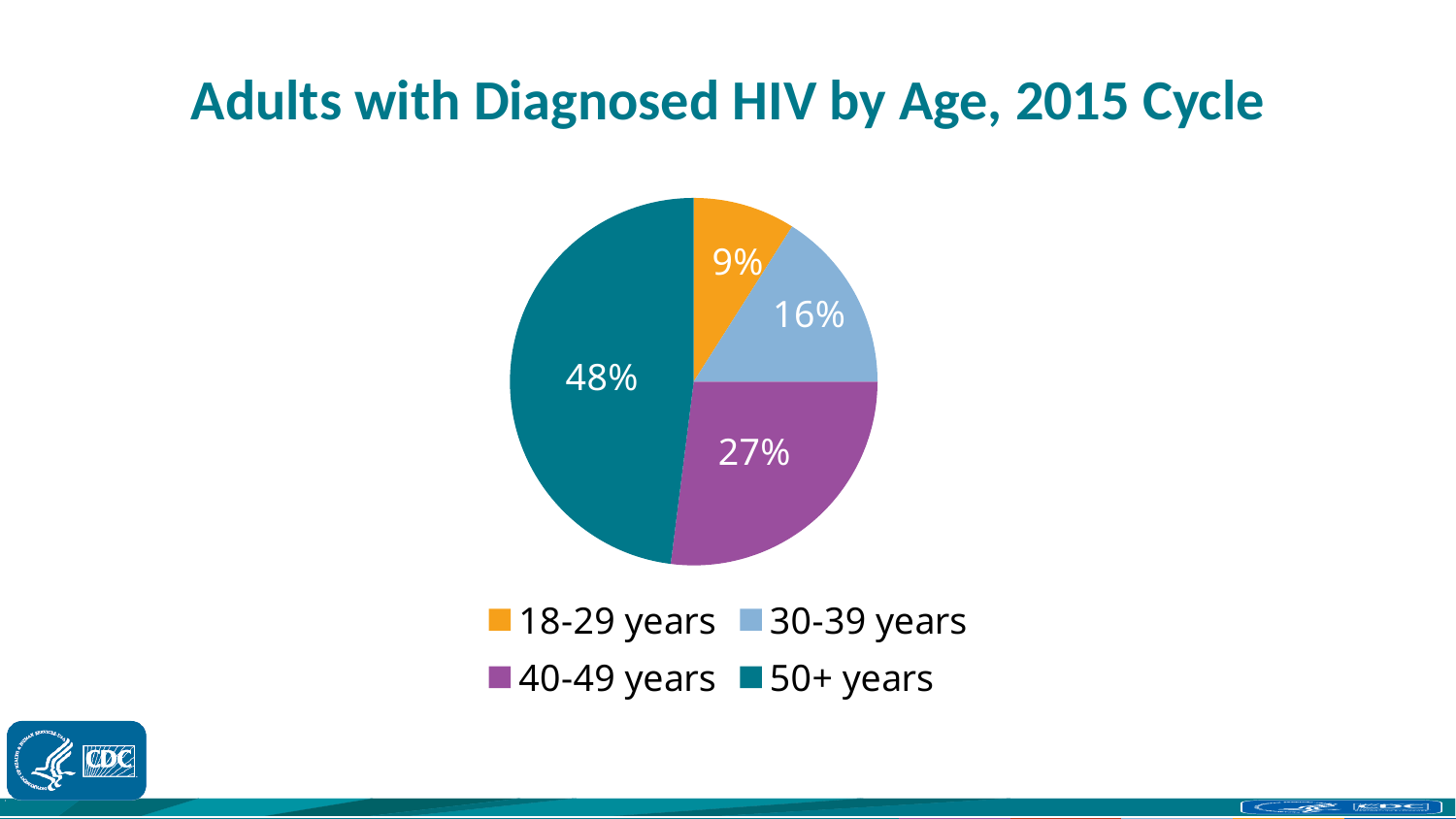
What kind of chart is shown on the slide? pie chart What percentage of adults with diagnosed HIV are aged 40-49 years? 27% What percentage of adults with diagnosed HIV are aged 30-39 years? 16% What is the difference in percentage points between the 50+ years and 40-49 years groups? 21 What percentage of adults with diagnosed HIV are aged 18-29 years? 9% What is the title of the chart? Adults with Diagnosed HIV by Age, 2015 Cycle How many age groups are shown in the pie chart? 4 What colour is the slice for the 18-29 years group? orange What percentage of adults with diagnosed HIV are aged 50+ years? 48% Which is larger, the share for 30-39 years or the share for 40-49 years? 40-49 years Which age group has the largest share of the pie? 50+ years Which age group has the smallest share of the pie? 18-29 years